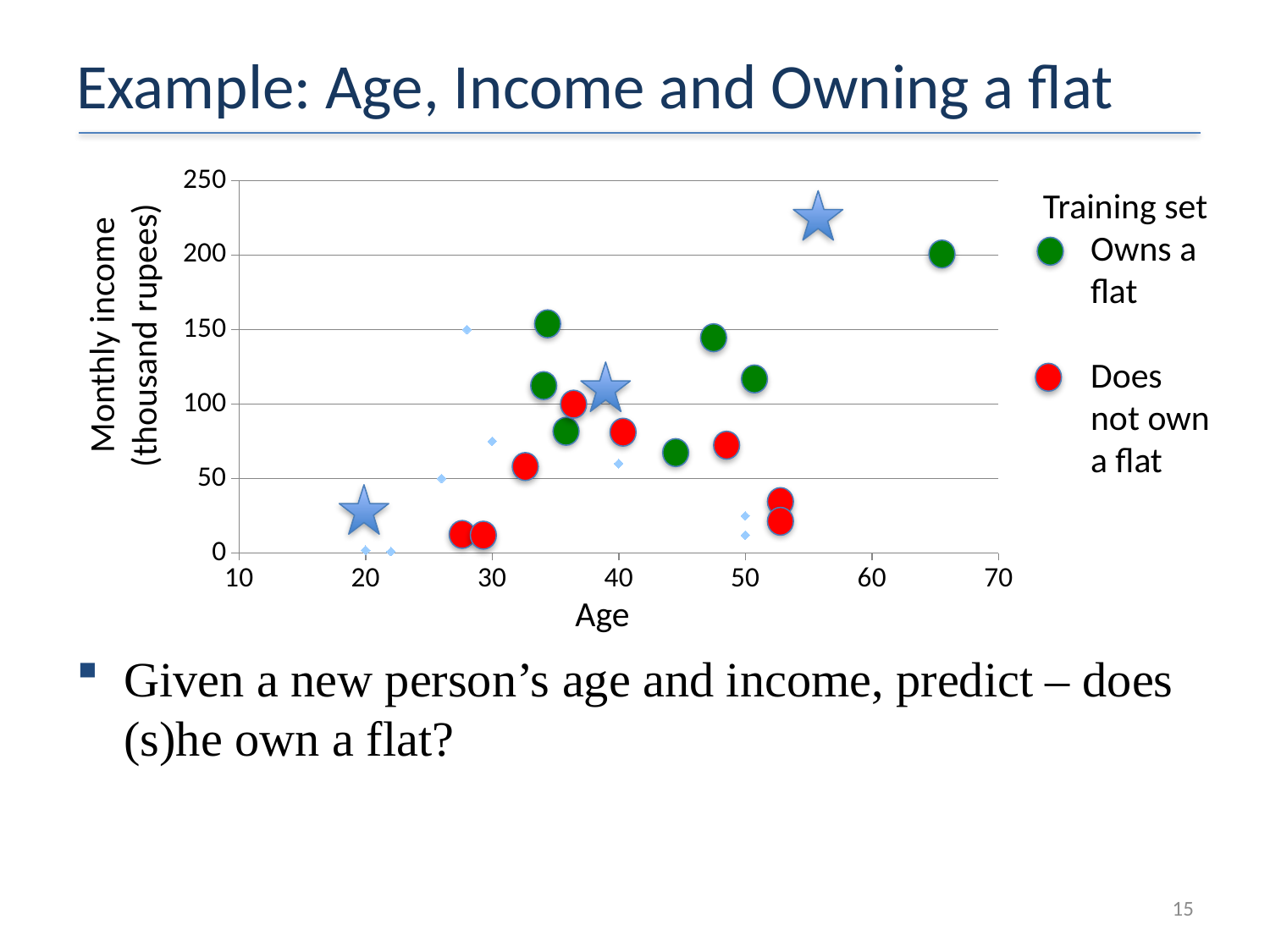
What is the label of the y axis of the chart? Monthly income (thousand rupees) Is the monthly income of the blue star at age around 20 greater or less than 50? less How many categories does the legend of the training set list? 2 How many green 'Owns a flat' points are plotted on the chart? 7 What is the label of the x axis of the chart? Age What kind of chart is shown on the slide? Scatter plot How many blue star markers are plotted on the chart? 3 Which legend category is shown with red circles? Does not own a flat Which legend category is shown with green circles? Owns a flat Is the monthly income of the blue star at age around 56 greater or less than 200? greater Is the monthly income of the oldest person in the training set (age around 65) greater or less than 150? greater